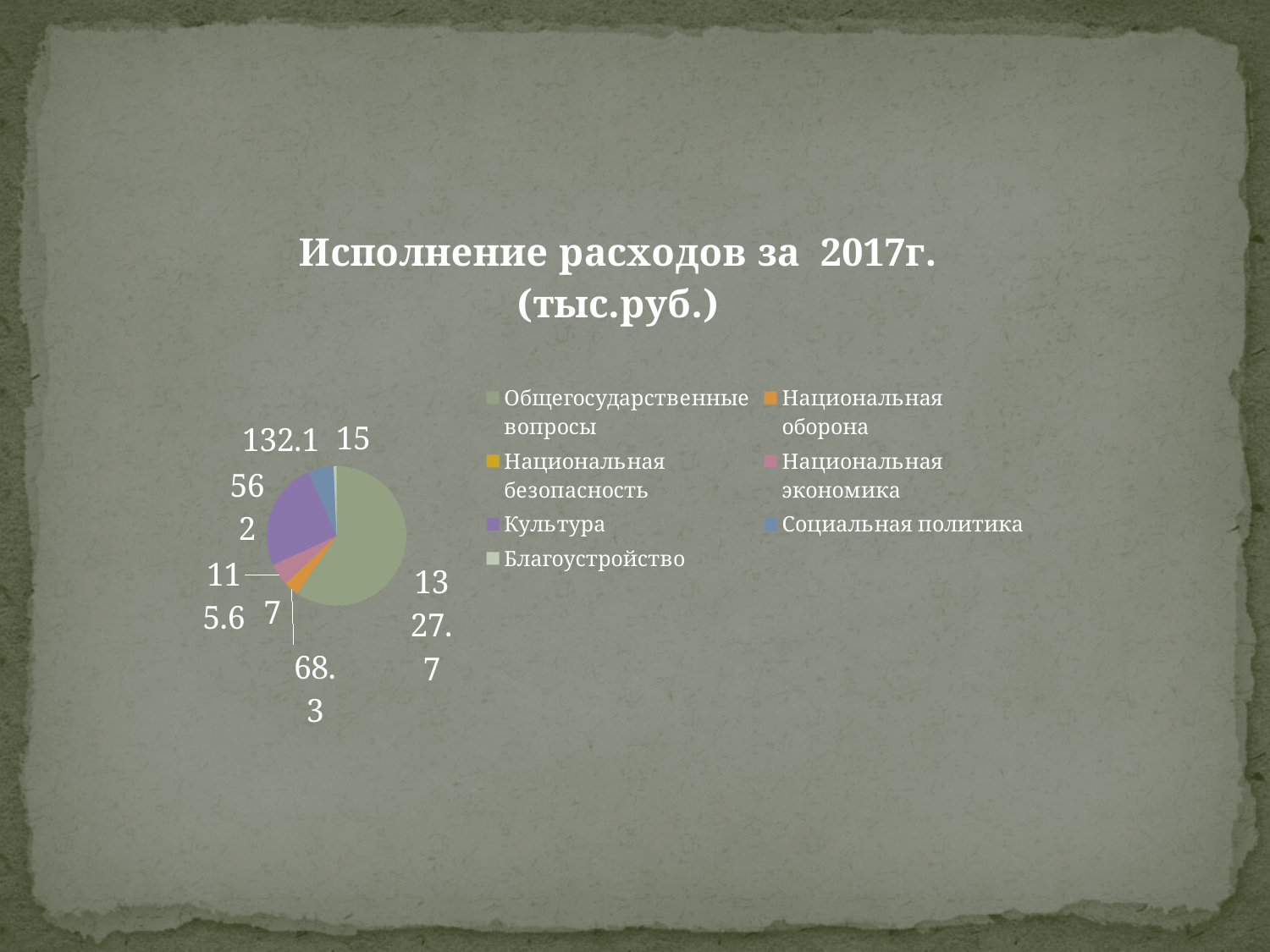
Which category has the smallest slice of the pie? Национальная безопасность What is the value for Национальная оборона? 68.3 What is the value for Социальная политика? 132.1 Which is larger, the value for Культура or the value for Социальная политика? Культура What is the difference between the value for Социальная политика and the value for Благоустройство? 117.1 What is the value for Общегосударственные вопросы? 1327.7 Which category has the largest slice of the pie? Общегосударственные вопросы What kind of chart is shown on the slide? pie chart What is the title of the chart? Исполнение расходов за 2017г. (тыс.руб.) How many categories does the legend of the pie chart list? 7 What is the value for Благоустройство? 15 What is the value for Культура? 562